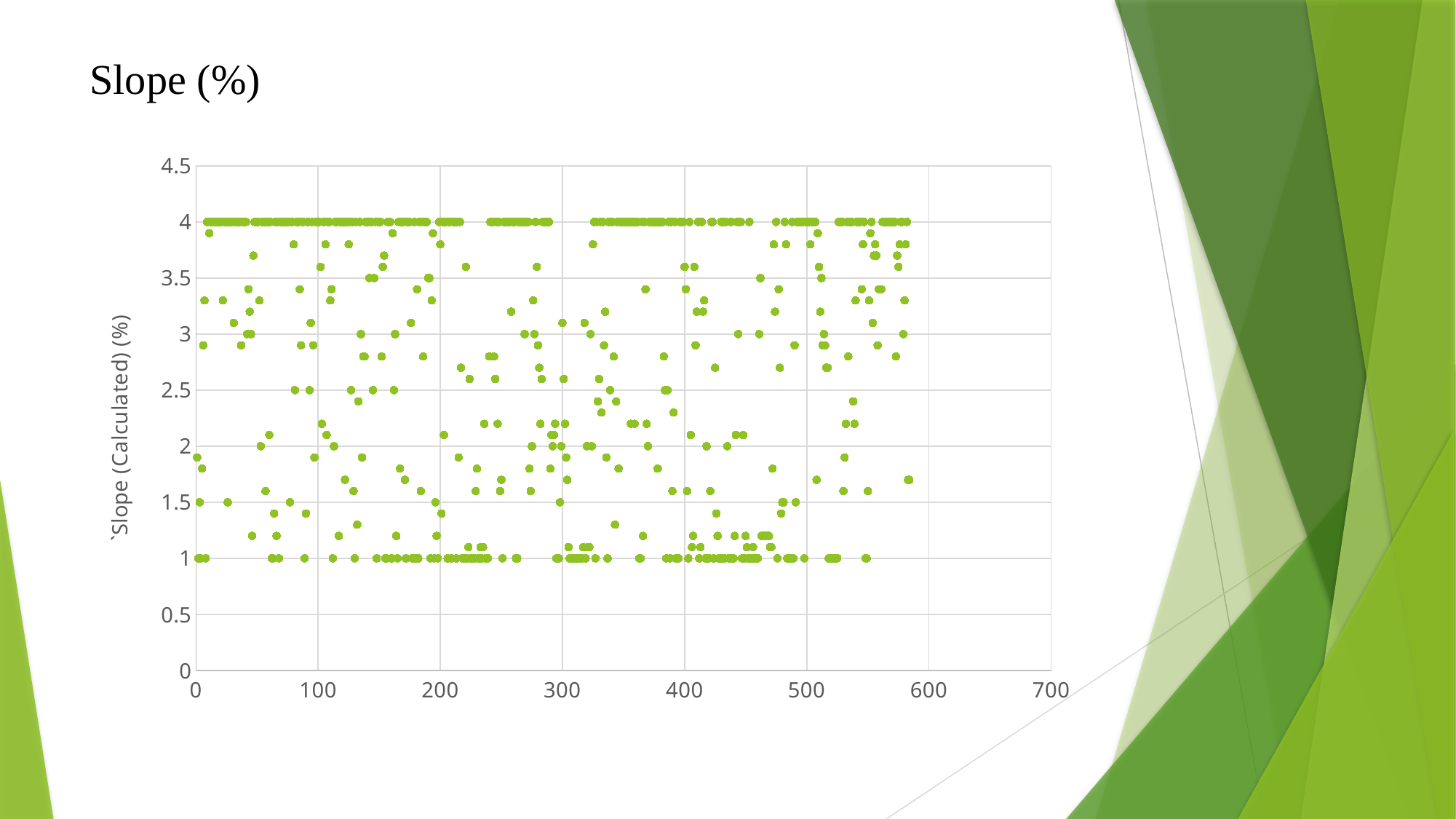
What is the title of the chart? Slope (%) Are any plotted points above 4 on the vertical axis? No Is the smallest plotted value on the vertical axis greater or less than 1.5? less What is the highest tick value shown on the vertical axis? 4.5 What kind of chart is shown on the slide? scatter chart Is the largest plotted value on the vertical axis greater or less than 3.5? greater What is the label on the vertical axis of the chart? Slope (Calculated) (%) What is the interval between consecutive tick marks on the vertical axis? 0.5 What is the highest tick value shown on the horizontal axis? 700